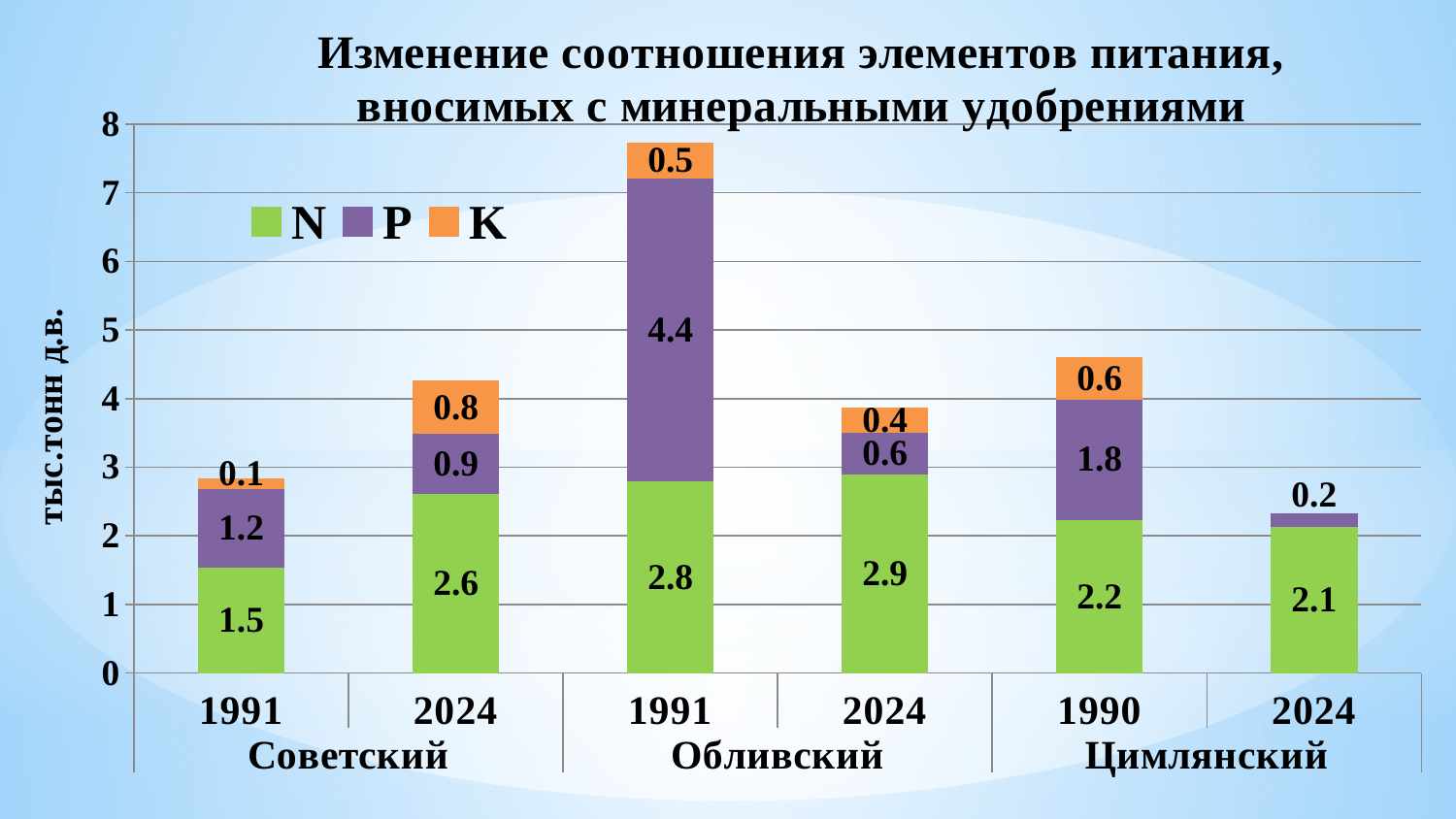
What is the difference between the P value for Обливский in 1991 and in 2024? 3.8 What is the value of P for Обливский in 1991? 4.4 What is the total of the stacked bar for Обливский in 1991? 7.7 What type of chart is shown on the slide? Stacked bar chart What is the value of P for Цимлянский in 1990? 1.8 Which is larger: the N value for Советский in 2024 or the N value for Цимлянский in 2024? Советский 2024 What is the value of K for Советский in 2024? 0.8 How many bars are plotted on the chart? 6 Which bar has the highest total value? Обливский 1991 How many series does the legend list? 3 What is the value of N for Обливский in 1991? 2.8 What is the total of the stacked bar for Советский in 1991? 2.8